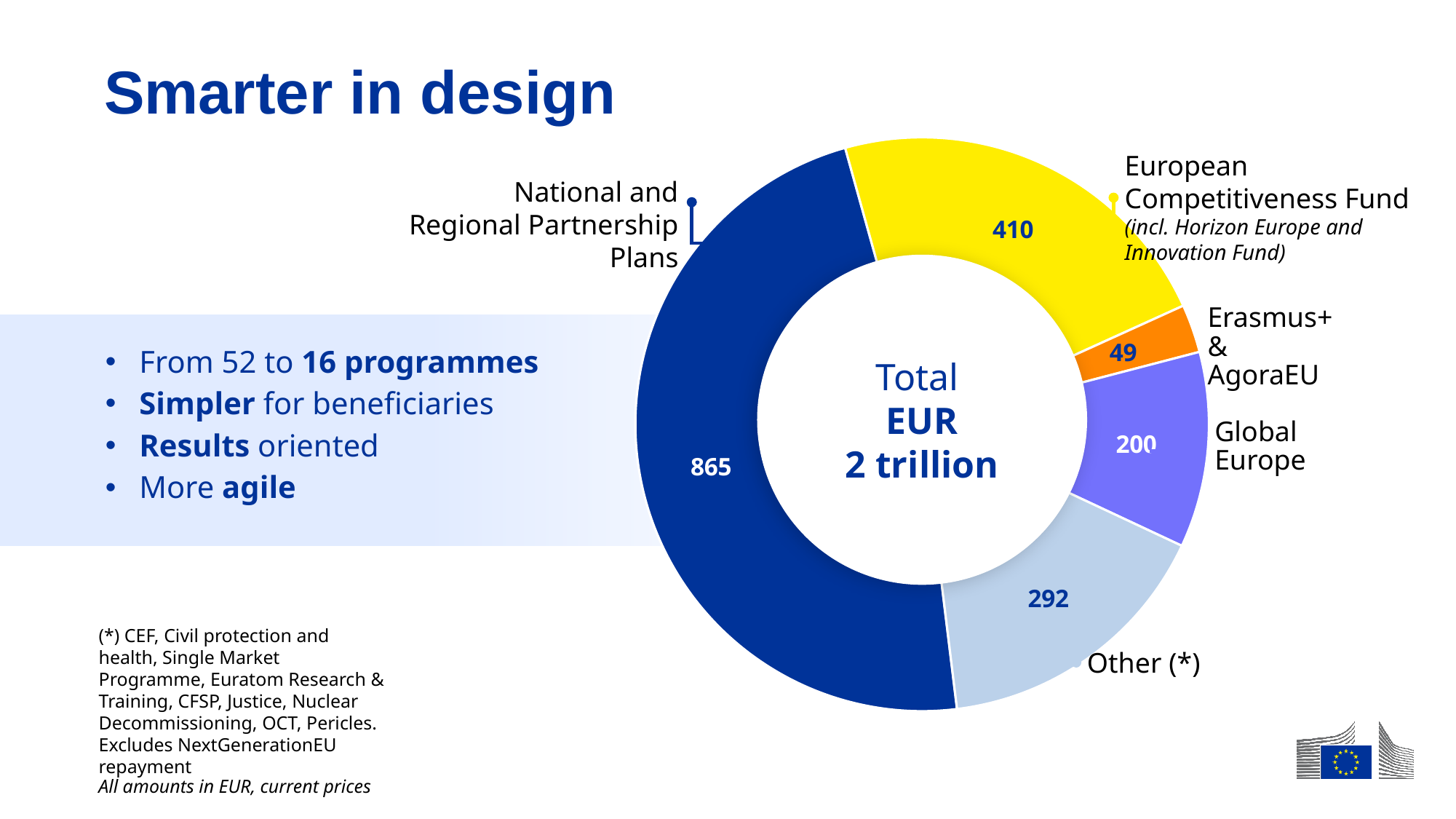
What is the value for Global Europe? 200 Which category has the smallest slice? Erasmus+ & AgoraEU What kind of chart is shown on the slide? pie chart (donut) What is the value for Other (*)? 292 Which category has the largest slice? National and Regional Partnership Plans How many categories are shown in the chart? 5 What is the value for National and Regional Partnership Plans? 865 What is the difference between the values for National and Regional Partnership Plans and the European Competitiveness Fund? 455 What is the value for Erasmus+ & AgoraEU? 49 Which is larger, Other (*) or Global Europe? Other (*) What is the value for the European Competitiveness Fund? 410 What total is printed in the centre of the chart? Total EUR 2 trillion